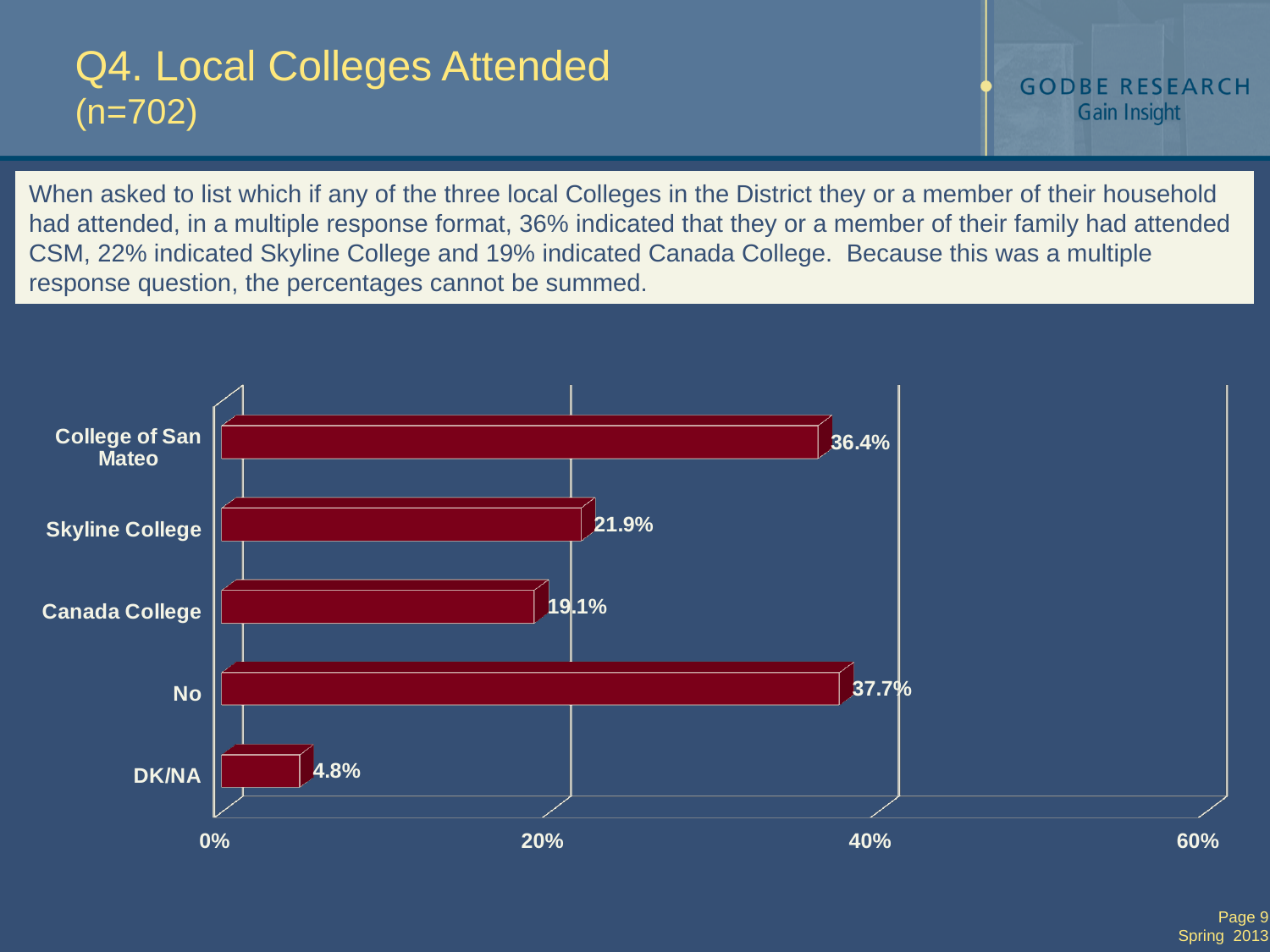
Which is larger, the value for Skyline College or the value for Canada College? Skyline College What kind of chart is shown on the slide? bar chart What is the difference between the values for College of San Mateo and Skyline College? 14.5% What is the value for DK/NA? 4.8% How many categories are shown in the chart? 5 Is the value for No greater or less than 40%? less Which category has the highest value? No What is the value for Canada College? 19.1% Which category has the lowest value? DK/NA What is the value for College of San Mateo? 36.4% What is the difference between the values for No and DK/NA? 32.9% What is the value for Skyline College? 21.9%